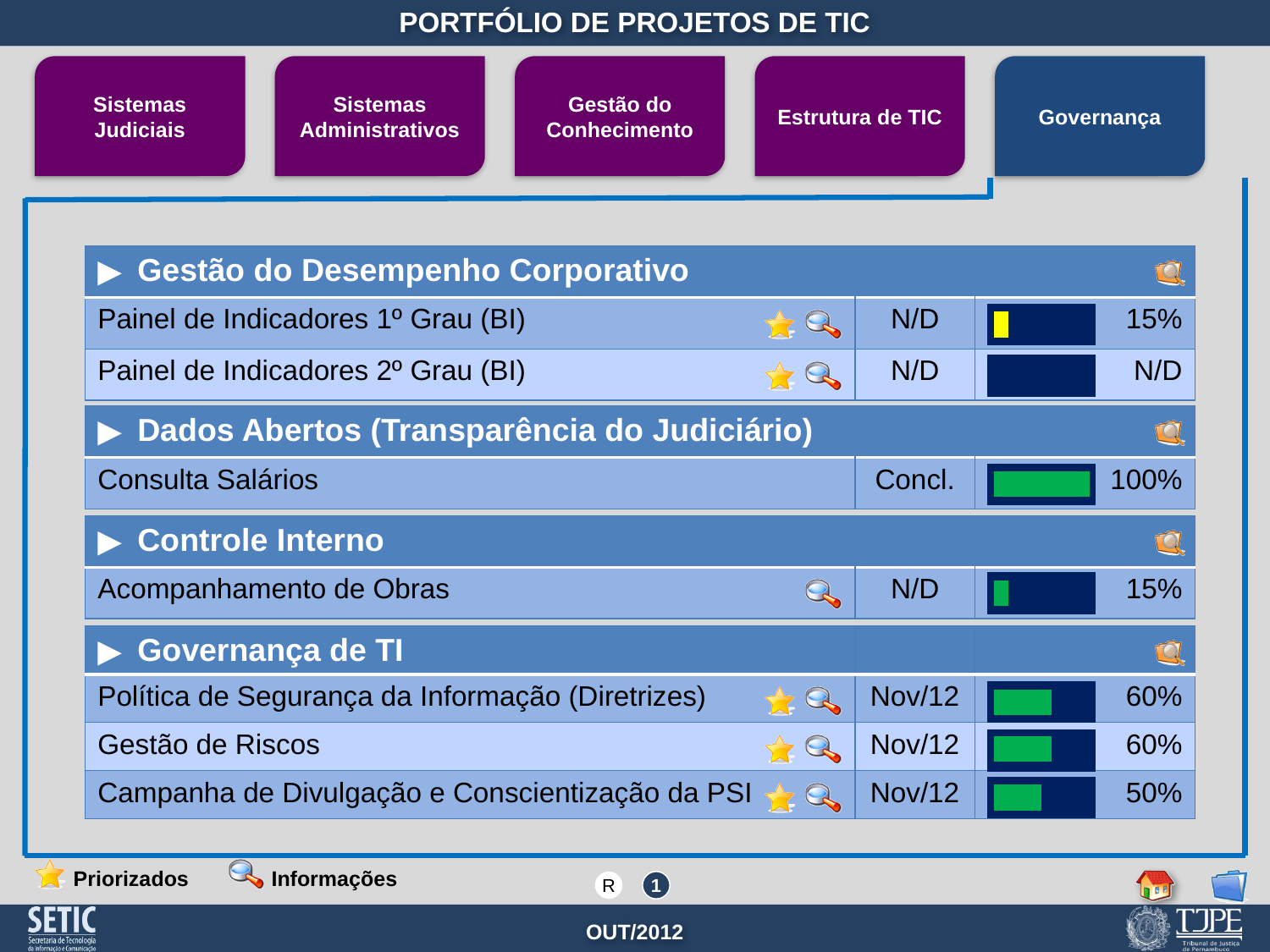
What deadline is shown for Gestão de Riscos? Nov/12 Which has a higher completion percentage, Gestão de Riscos or Acompanhamento de Obras? Gestão de Riscos What completion percentage is shown for Consulta Salários? 100% How many projects are listed with progress bars on the slide? 7 What status is shown for Consulta Salários? Concl. What completion percentage is shown for Painel de Indicadores 1º Grau (BI)? 15% What is the difference in completion percentage between Política de Segurança da Informação (Diretrizes) and Campanha de Divulgação e Conscientização da PSI? 10% Which project's progress bar is filled in yellow rather than green? Painel de Indicadores 1º Grau (BI) What completion percentage is shown for Campanha de Divulgação e Conscientização da PSI? 50% Which project has the highest completion percentage in the progress bars? Consulta Salários What completion value is shown for Painel de Indicadores 2º Grau (BI)? N/D How many projects show a completion of 60%? 2